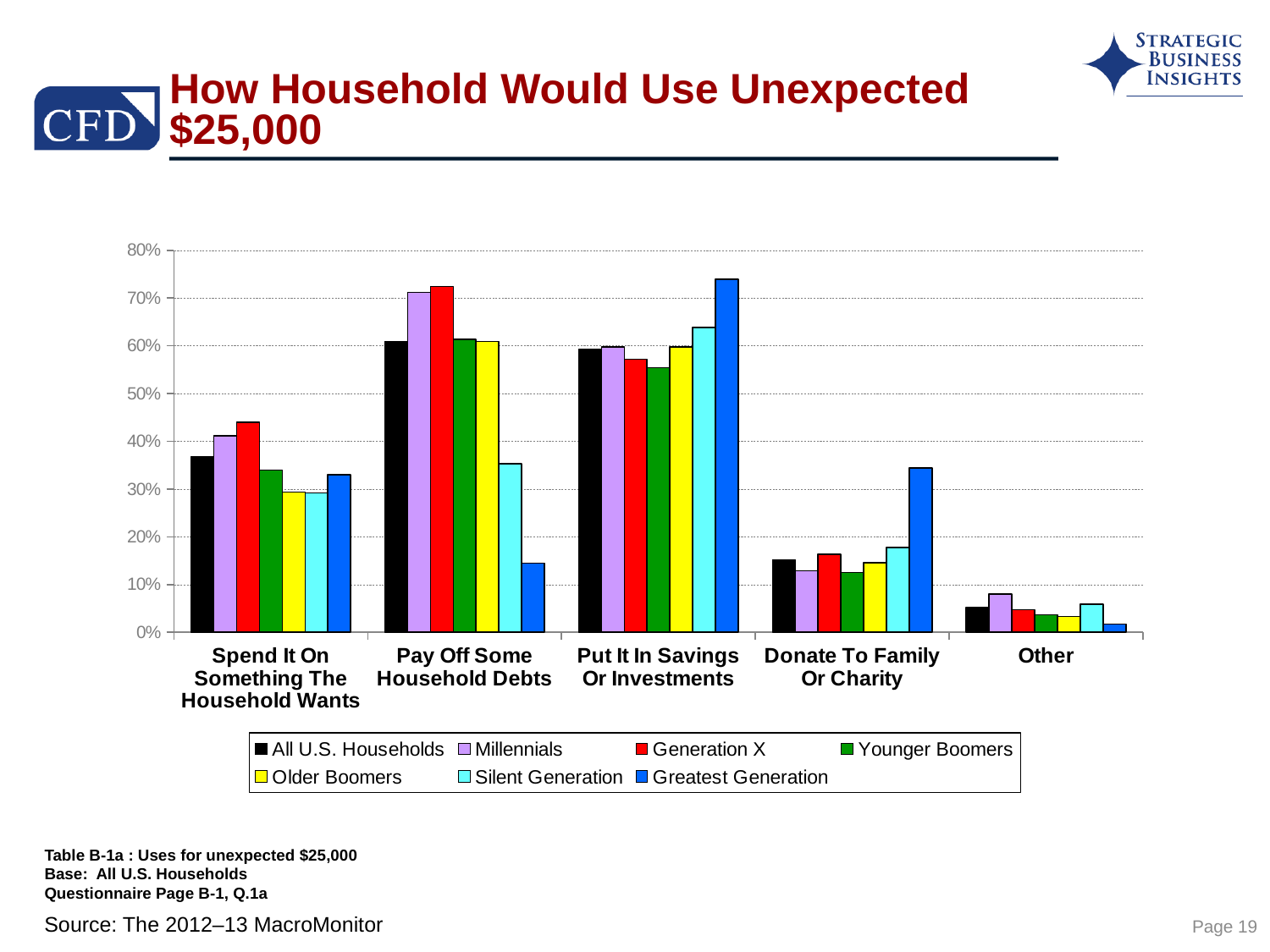
Is the value for Greatest Generation under Put It In Savings Or Investments greater or less than 70%? greater Which series has the highest bar for Donate To Family Or Charity? Greatest Generation How many categories are shown along the x axis? 5 What kind of chart is shown on the slide? Bar chart Is the value for Greatest Generation under Pay Off Some Household Debts greater or less than 20%? less Under Spend It On Something The Household Wants, which is larger: Millennials or Generation X? Generation X Is the value for Silent Generation under Pay Off Some Household Debts greater or less than 40%? less Which series has the lowest bar for Pay Off Some Household Debts? Greatest Generation What is the title of the chart? How Household Would Use Unexpected $25,000 How many series does the legend list? 7 For the Greatest Generation, which category has the highest bar? Put It In Savings Or Investments